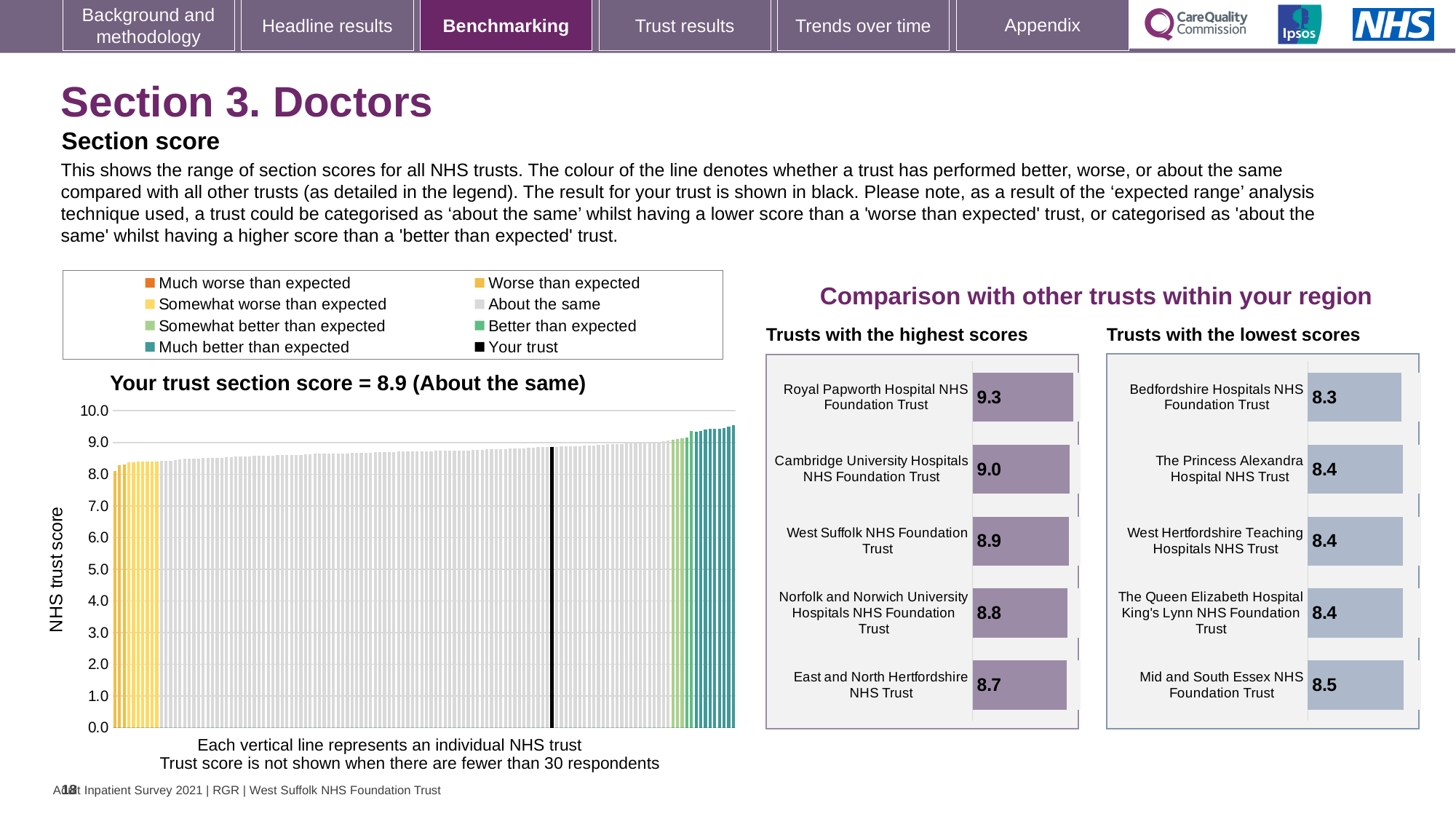
In the 'Trusts with the highest scores' chart, which trust has the highest score? Royal Papworth Hospital NHS Foundation Trust In the main section score chart on the left, do the trust scores rise or fall from left to right along the x axis? Rise In the 'Trusts with the highest scores' chart, what is the score for Royal Papworth Hospital NHS Foundation Trust? 9.3 In the main section score chart on the left, what is the section score for your trust? 8.9 In the 'Trusts with the highest scores' chart, which has the larger score: Cambridge University Hospitals NHS Foundation Trust or Norfolk and Norwich University Hospitals NHS Foundation Trust? Cambridge University Hospitals NHS Foundation Trust What kind of chart is the main section score chart on the left? Bar chart How many trusts are shown in the 'Trusts with the highest scores' chart? 5 In the 'Trusts with the highest scores' chart, what is the difference between the scores of Royal Papworth Hospital NHS Foundation Trust and East and North Hertfordshire NHS Trust? 0.6 In the 'Trusts with the lowest scores' chart, what is the score for Mid and South Essex NHS Foundation Trust? 8.5 In the 'Trusts with the lowest scores' chart, which trust has the lowest score? Bedfordshire Hospitals NHS Foundation Trust How many entries does the legend above the main section score chart list? 8 In the 'Trusts with the lowest scores' chart, what is the score for Bedfordshire Hospitals NHS Foundation Trust? 8.3